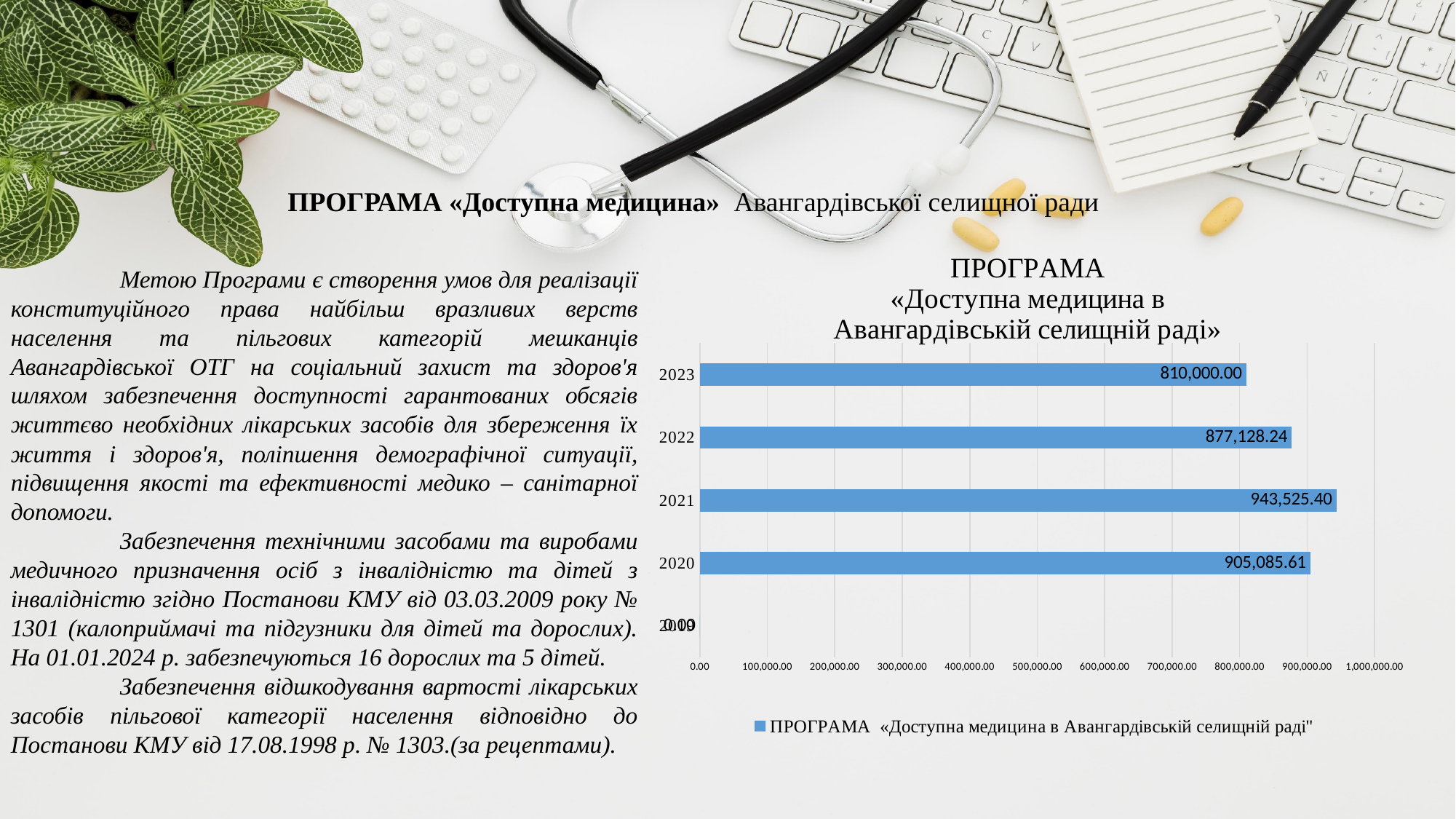
Which year has the highest value in the chart? 2021 What kind of chart is shown on the slide? bar chart What is the value for 2020 in the chart? 905,085.61 What is the difference between the values for 2020 and 2023? 95,085.61 What is the value for 2021 in the chart? 943,525.40 What is the value for 2022 in the chart? 877,128.24 Which year has the lowest value among the labelled bars in the chart? 2023 What is the difference between the values for 2021 and 2020? 38,439.79 What is the value for 2023 in the chart? 810,000.00 Which is larger, the value for 2022 or the value for 2020? 2020 How many series does the chart legend list? 1 Is the value for 2023 greater or less than 900,000.00? less